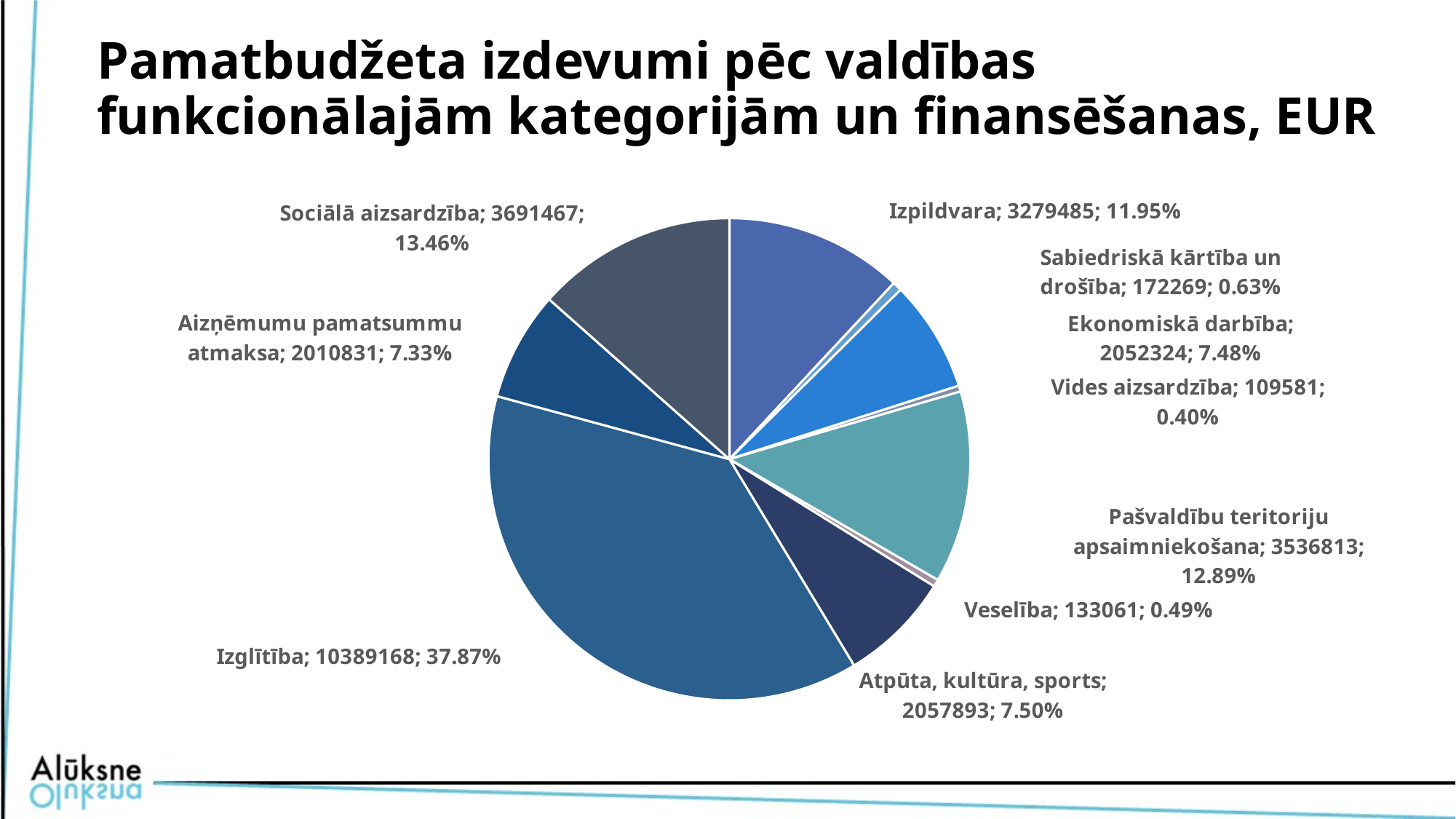
Which category has the largest share of the pie? Izglītība What share of the pie does Veselība represent? 0.49% Which category has the smallest share of the pie? Vides aizsardzība What type of chart is shown on the slide? pie chart What is the difference between the values for Sociālā aizsardzība and Pašvaldību teritoriju apsaimniekošana? 154654 Which is larger, the value for Izpildvara or the value for Ekonomiskā darbība? Izpildvara What is the title of the chart on the slide? Pamatbudžeta izdevumi pēc valdības funkcionālajām kategorijām un finansēšanas, EUR What is the value for Izglītība? 10389168 What is the value for Aizņēmumu pamatsummu atmaksa? 2010831 What share of the pie does Sociālā aizsardzība represent? 13.46% What is the value for Pašvaldību teritoriju apsaimniekošana? 3536813 How many categories does the pie chart show? 10